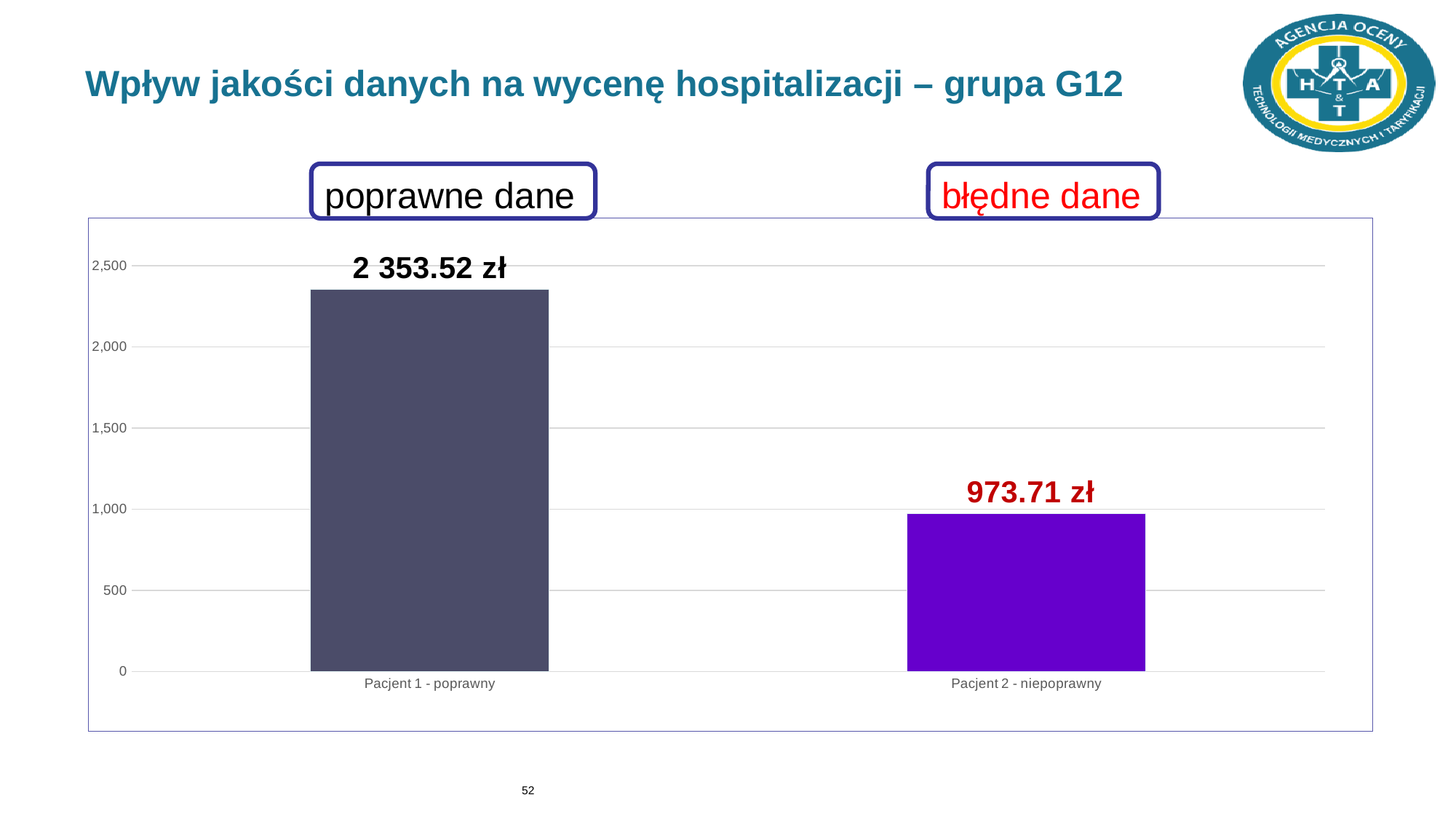
What kind of chart is shown on the slide? bar chart Which is larger, the value for Pacjent 1 - poprawny or for Pacjent 2 - niepoprawny? Pacjent 1 - poprawny Is the value for Pacjent 2 - niepoprawny greater or less than 1,000? less What is the value shown for Pacjent 1 - poprawny? 2 353.52 zł What is the difference between the values for Pacjent 1 - poprawny and Pacjent 2 - niepoprawny? 1 379.81 zł What label appears in the box above the Pacjent 2 - niepoprawny bar? błędne dane How many categories are shown on the chart? 2 Which category has the lowest value? Pacjent 2 - niepoprawny What is the title of the slide containing the chart? Wpływ jakości danych na wycenę hospitalizacji – grupa G12 Is the value for Pacjent 1 - poprawny greater or less than 2,000? greater Which category has the highest value? Pacjent 1 - poprawny What is the value shown for Pacjent 2 - niepoprawny? 973.71 zł